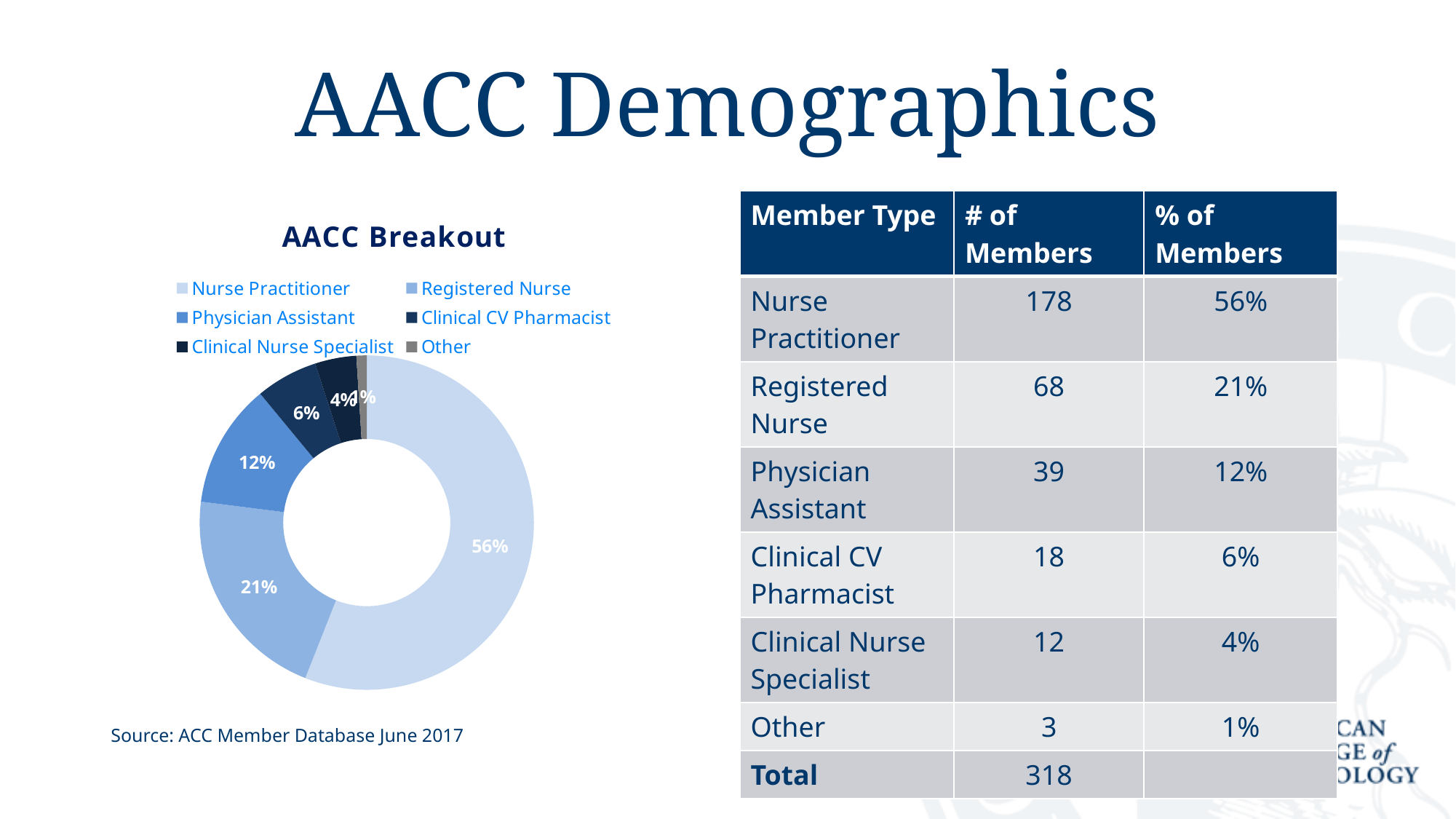
In the AACC Breakout chart, which is larger: Registered Nurse or Physician Assistant? Registered Nurse Which category has the largest slice in the AACC Breakout chart? Nurse Practitioner What share of the AACC Breakout chart is Clinical CV Pharmacist? 6% How many categories does the legend of the AACC Breakout chart list? 6 What is the title of the chart on the slide? AACC Breakout What share of the AACC Breakout chart is Physician Assistant? 12% In the AACC Breakout chart, what is the difference in percentage points between Nurse Practitioner and Registered Nurse? 35 What share of the AACC Breakout chart is Nurse Practitioner? 56% Which category has the smallest slice in the AACC Breakout chart? Other In the AACC Breakout chart, what is the difference in percentage points between Physician Assistant and Clinical CV Pharmacist? 6 What kind of chart is the AACC Breakout chart? Doughnut chart